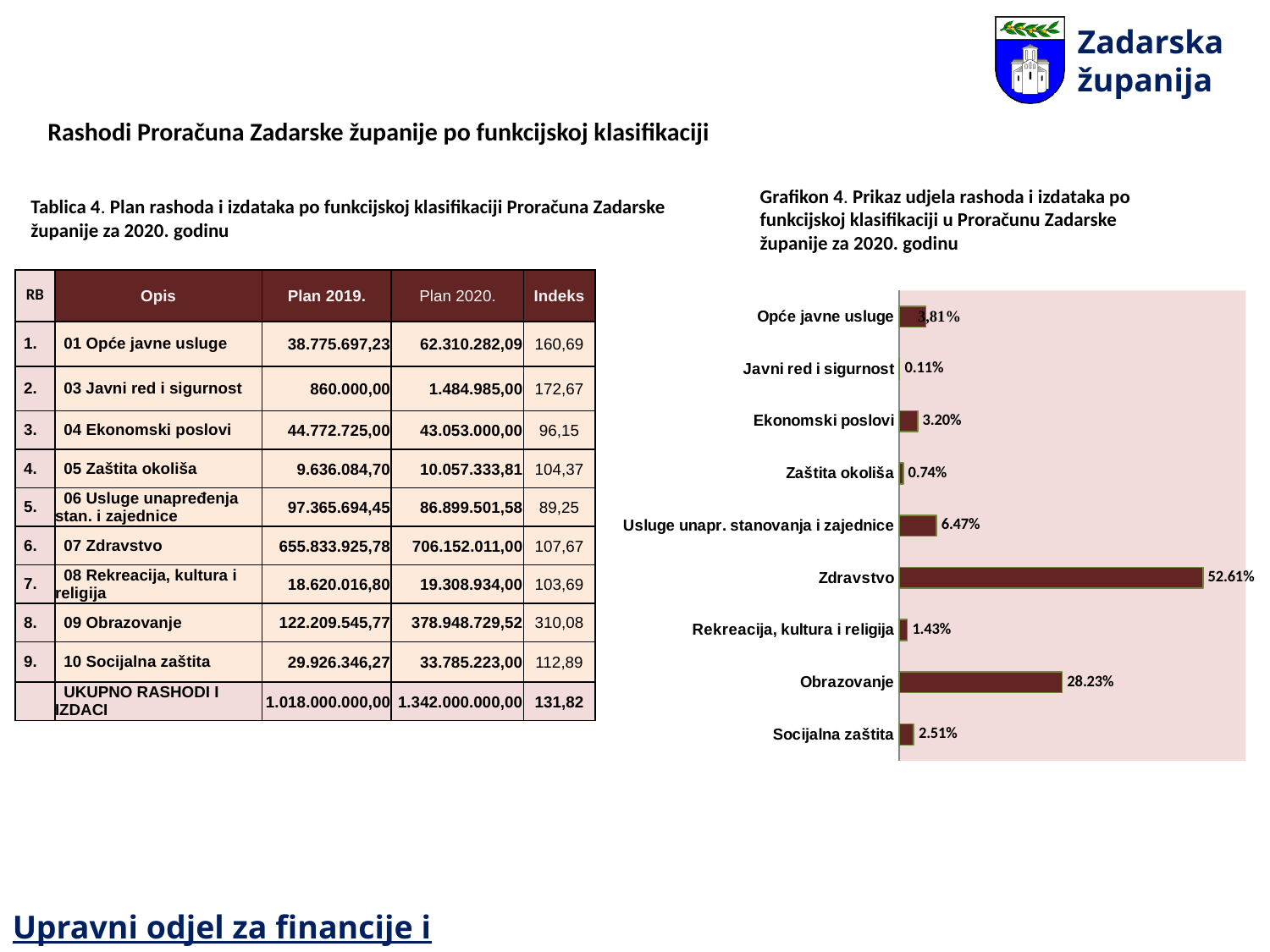
What is the value shown for Usluge unapr. stanovanja i zajednice in the chart? 6.47% What share does Zdravstvo have in the chart 'Grafikon 4'? 52.61% What is the difference between the shares of Zdravstvo and Obrazovanje in the chart? 24.38% What is the value shown for Socijalna zaštita in the chart? 2.51% What is the value shown for Javni red i sigurnost in the chart? 0.11% What is the difference between the shares of Obrazovanje and Usluge unapr. stanovanja i zajednice? 21.76% Which category has the highest share in the chart? Zdravstvo Which category has the lowest share in the chart? Javni red i sigurnost What share does Obrazovanje have in the chart? 28.23% Which has a larger share in the chart, Ekonomski poslovi or Socijalna zaštita? Ekonomski poslovi What type of chart is shown on the slide? Bar chart How many categories are shown in the chart? 9